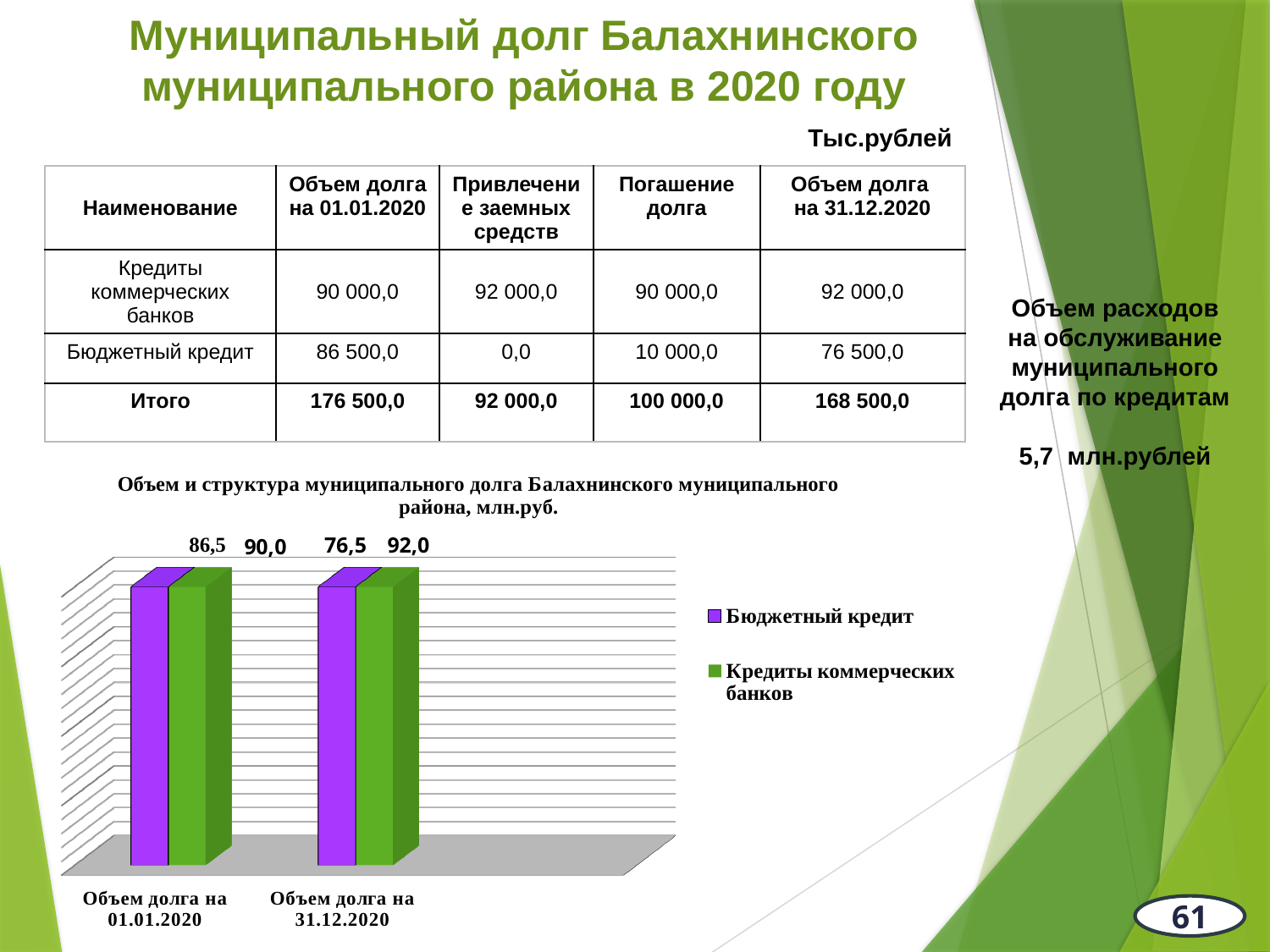
How many series does the chart legend list? 2 Which series has the higher value for Объем долга на 31.12.2020? Кредиты коммерческих банков What is the value of Бюджетный кредит for Объем долга на 01.01.2020? 86,5 What is the value of Кредиты коммерческих банков for Объем долга на 01.01.2020? 90,0 By how much did Бюджетный кредит change from Объем долга на 01.01.2020 to Объем долга на 31.12.2020? 10,0 Does the value of Кредиты коммерческих банков rise or fall from 01.01.2020 to 31.12.2020? rise Does the value of Бюджетный кредит rise or fall from 01.01.2020 to 31.12.2020? fall What type of chart is shown on the slide? bar chart What is the value of Бюджетный кредит for Объем долга на 31.12.2020? 76,5 How many categories are shown on the x axis of the chart? 2 What is the difference between Кредиты коммерческих банков and Бюджетный кредит for Объем долга на 31.12.2020? 15,5 What is the value of Кредиты коммерческих банков for Объем долга на 31.12.2020? 92,0